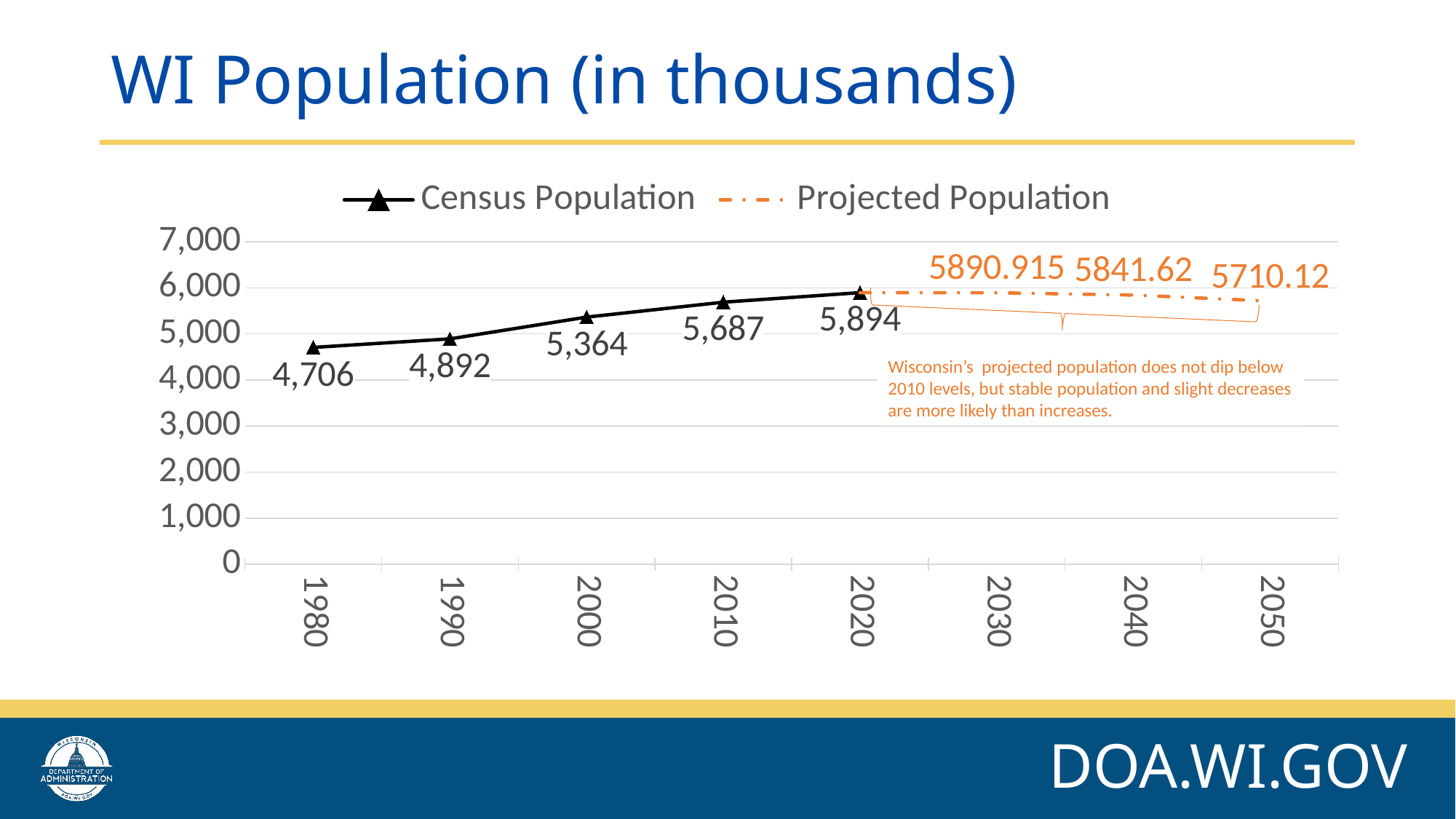
What is the Census Population value for 2020? 5,894 What is the difference between the Census Population in 2020 and in 1980? 1,188 What is the Census Population value for 1980? 4,706 Do the Census Population values rise or fall from 1980 to 2020? Rise What is the Projected Population value for 2050? 5710.12 What is the Projected Population value for 2030? 5890.915 Which is larger, the Projected Population for 2040 or for 2050? 2040 Which year has the highest Census Population value? 2020 How many series does the legend list? 2 What kind of chart is shown on the slide? Line chart Which year has the lowest Census Population value? 1980 What is the title of the chart? WI Population (in thousands)